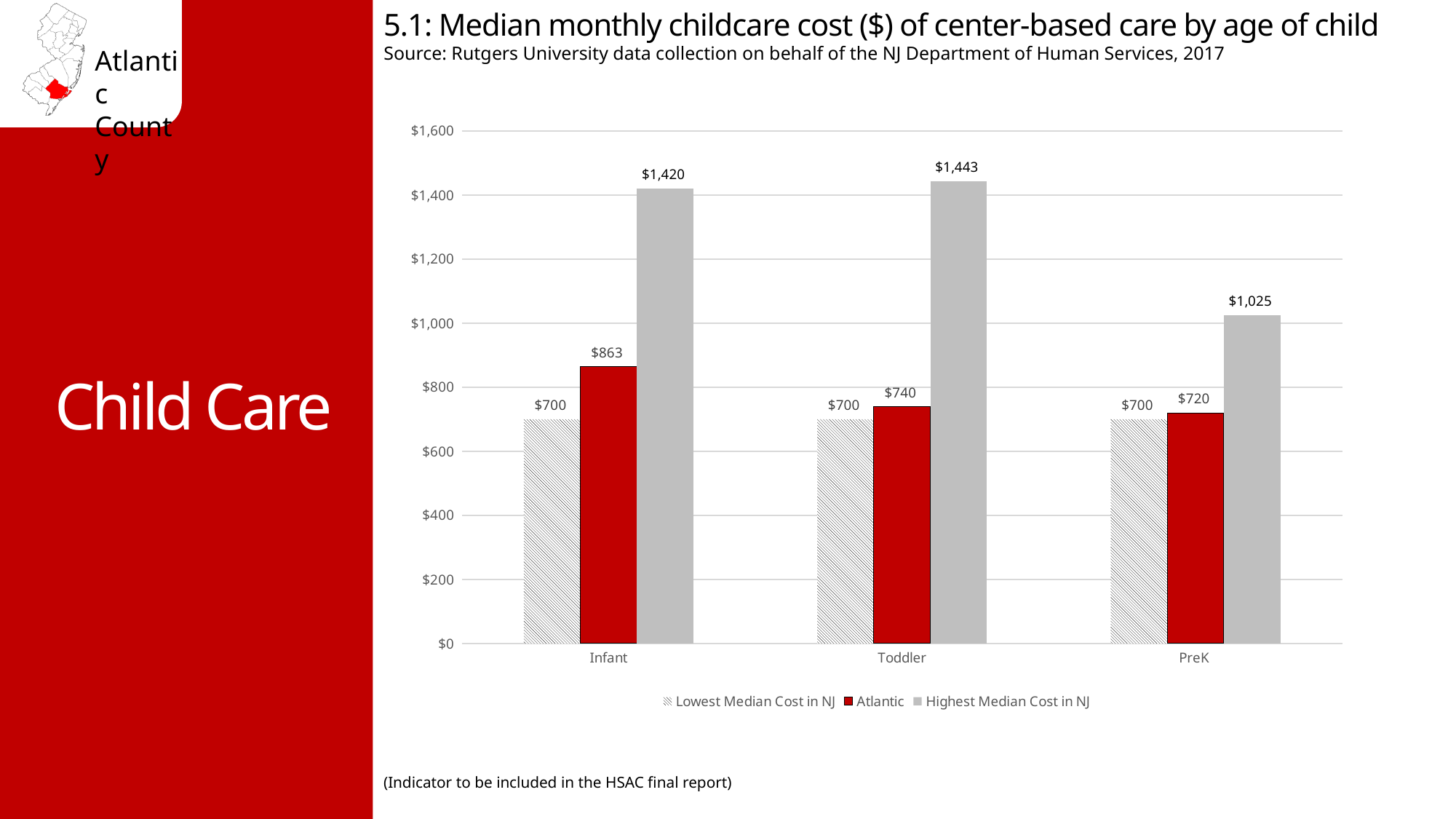
What is the difference between the Highest Median Cost in NJ and the Atlantic cost for Infant care? $557 What is the Lowest Median Cost in NJ for PreK care? $700 How many series does the legend list? 3 What is the Highest Median Cost in NJ for Toddler care? $1,443 What is the difference between the Atlantic cost for Toddler care and the Atlantic cost for PreK care? $20 What is the Atlantic median monthly childcare cost for Infant care? $863 How many age groups are shown on the x axis? 3 Which age group has the highest Atlantic median monthly cost? Infant What kind of chart is shown on the slide? Bar chart Which series is shown in red? Atlantic Which age group has the lowest Highest Median Cost in NJ? PreK Which is larger: the Highest Median Cost in NJ for Infant care or for Toddler care? Toddler